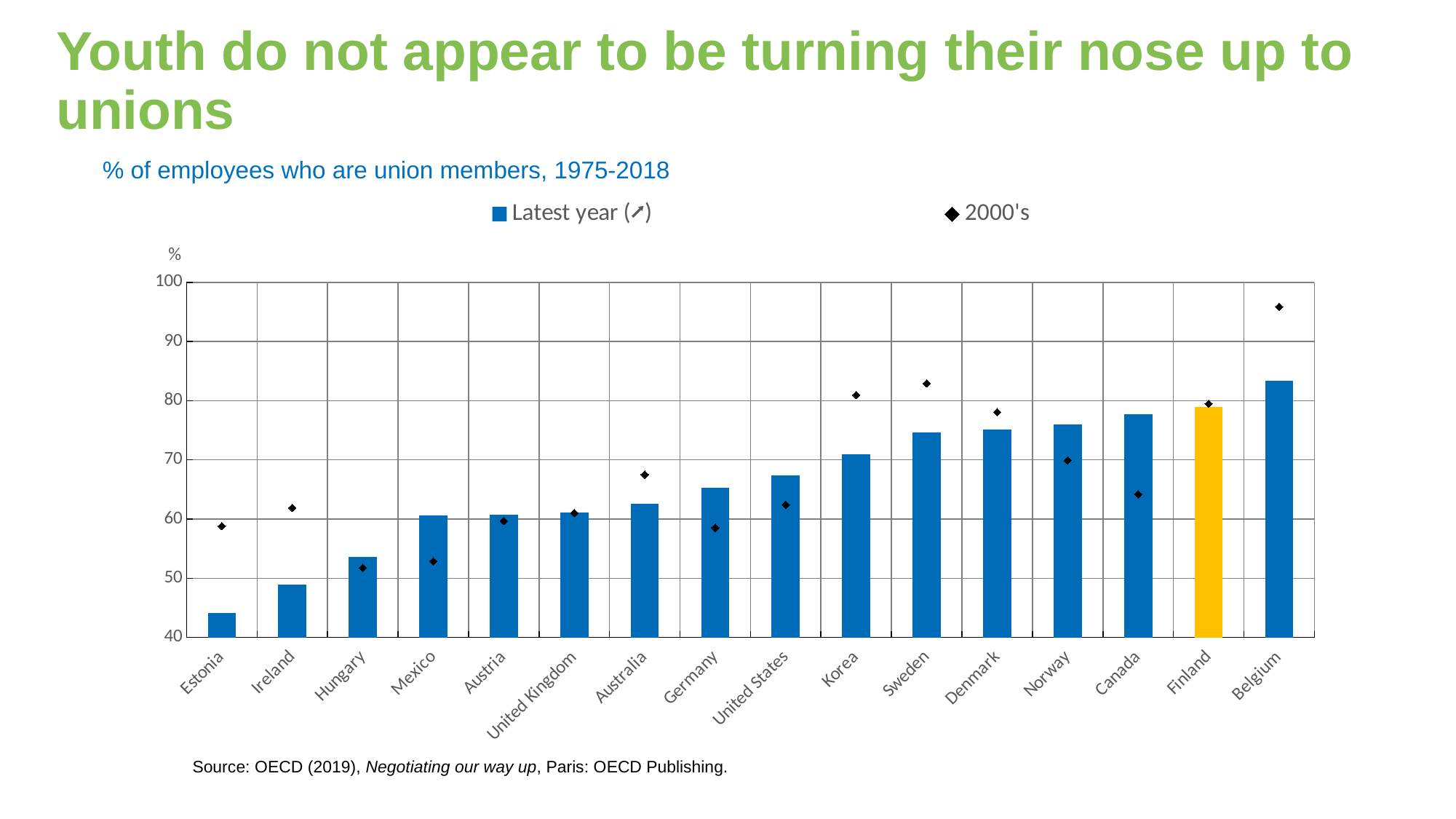
Is the Latest year value for Estonia greater or less than 50? less Which country has the highest Latest year value? Belgium For Korea, which is larger: the Latest year value or the 2000's value? 2000's Is the Latest year value for Belgium greater or less than 80? greater How many series does the chart legend list? 2 Is the 2000's value for Canada greater or less than 70? less Do the Latest year bars rise or fall from left to right along the x axis? rise Which country's Latest year bar is coloured yellow instead of blue? Finland What kind of chart is shown on the slide? bar chart How many countries are shown on the x axis of the chart? 16 Which country has the lowest Latest year value? Estonia